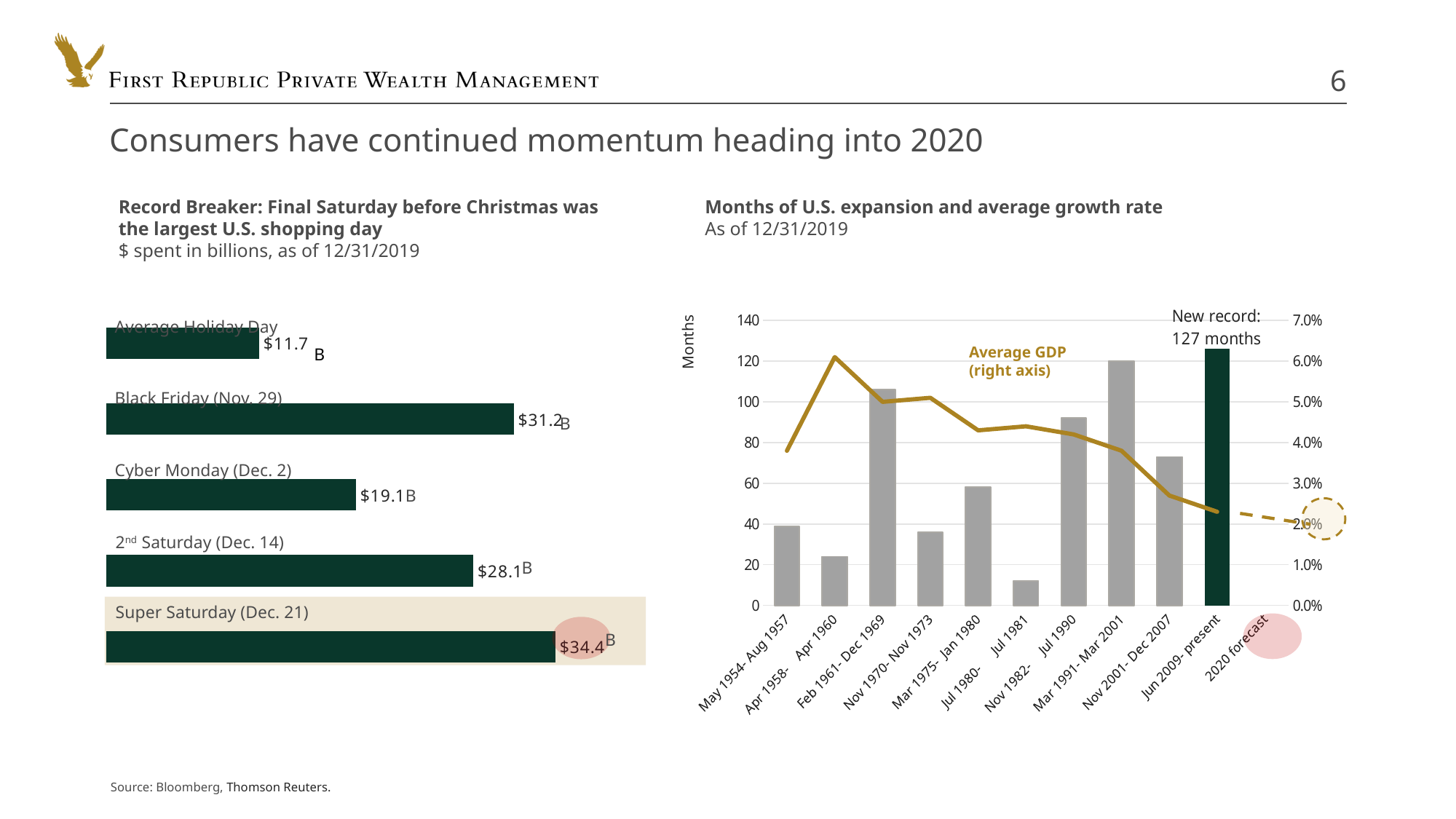
How many shopping-day categories are shown in the 'Record Breaker' chart? 5 In the 'Months of U.S. expansion' chart, is the value for Mar 1991-Mar 2001 greater or less than 100 months? greater In the 'Record Breaker' chart, which shopping day has the lowest spending? Average Holiday Day In the 'Record Breaker' chart, which is larger: 2nd Saturday (Dec. 14) or Cyber Monday (Dec. 2)? 2nd Saturday (Dec. 14) In the 'Record Breaker' chart, how much was spent on Super Saturday (Dec. 21)? $34.4B In the 'Record Breaker' chart, what is the difference between Super Saturday (Dec. 21) and Black Friday (Nov. 29)? $3.2B In the 'Months of U.S. expansion' chart, on which axis is the Average GDP line plotted? Right axis In the 'Months of U.S. expansion' chart, is the value for Jul 1980-Jul 1981 greater or less than 20 months? less In the 'Record Breaker' chart, which shopping day has the highest spending? Super Saturday (Dec. 21) In the 'Record Breaker' chart, what is the value for Cyber Monday (Dec. 2)? $19.1B In the 'Record Breaker' chart, how much was spent on Black Friday (Nov. 29)? $31.2B In the 'Months of U.S. expansion' chart, how many months long is the Jun 2009-present expansion? 127 months